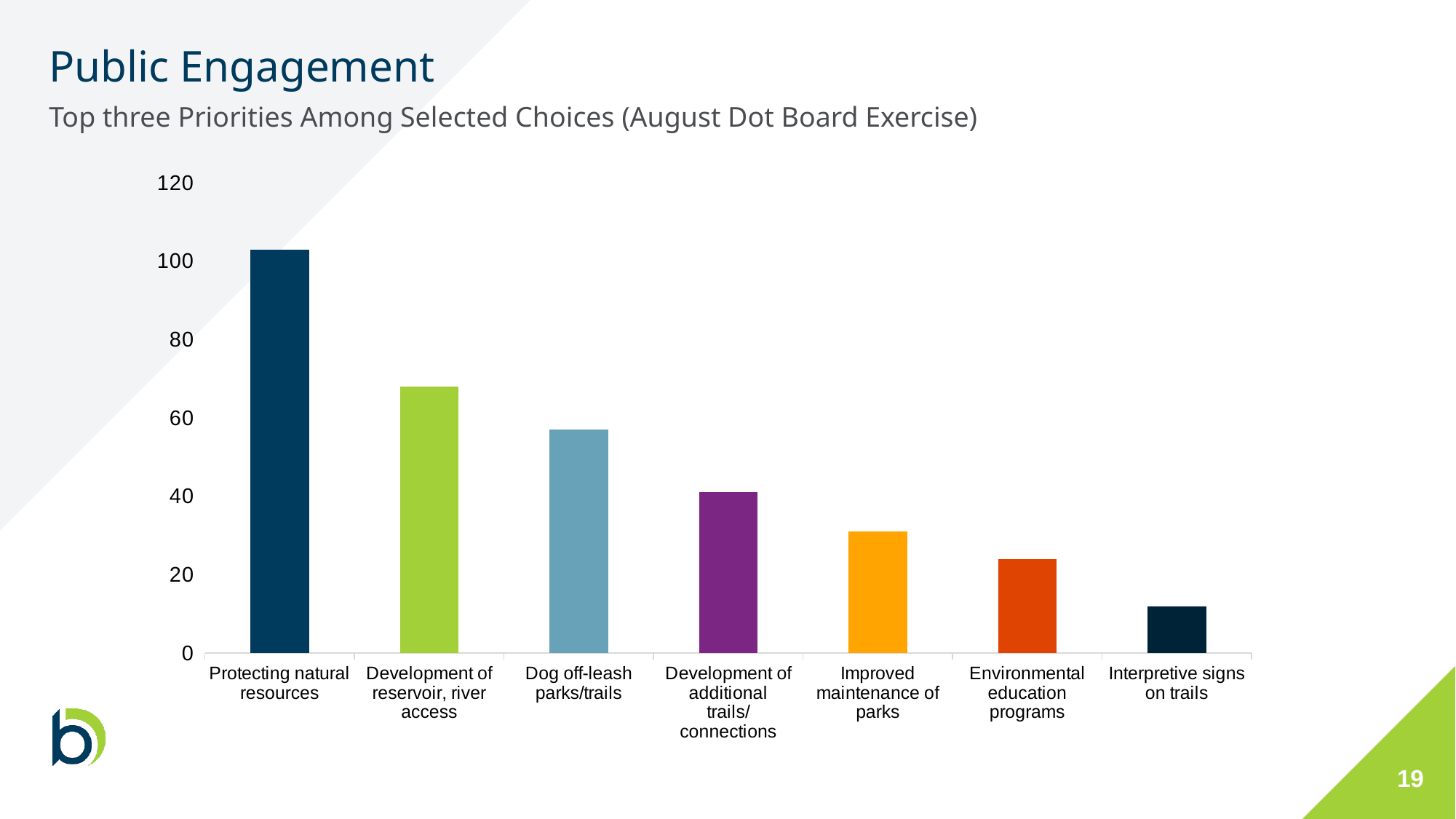
What kind of chart is shown on the slide? bar chart Is the value for Improved maintenance of parks greater or less than 40? less Which category has the highest value in the chart? Protecting natural resources Is the value for Development of reservoir, river access greater or less than 80? less How many categories are shown on the x axis of the chart? 7 Is the value for Development of additional trails/connections greater or less than 60? less Do the bar values rise or fall from left to right along the x axis? fall Which is larger, the value for Dog off-leash parks/trails or the value for Environmental education programs? Dog off-leash parks/trails Which category has the lowest value in the chart? Interpretive signs on trails